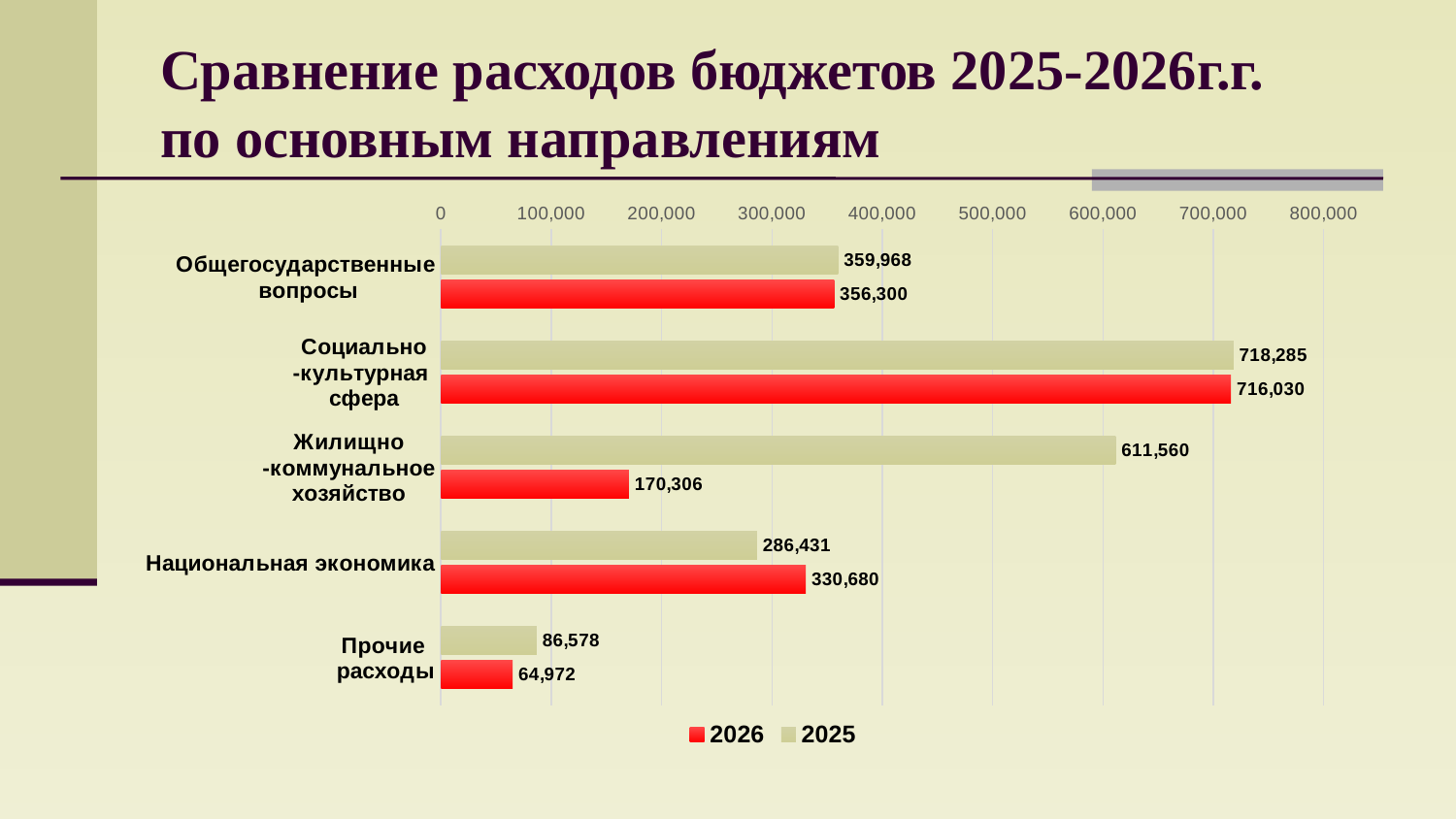
How many series does the legend list? 2 Which category has the highest 2026 value? Социально-культурная сфера Which category has the lowest 2025 value? Прочие расходы What is the 2026 value for Национальная экономика? 330,680 How many categories are shown on the chart? 5 What is the 2025 value for Жилищно-коммунальное хозяйство? 611,560 For Национальная экономика, which is larger: the 2025 value or the 2026 value? 2026 What kind of chart is shown on the slide? Bar chart Which colour represents the 2026 series? Red What is the 2026 value for Прочие расходы? 64,972 What is the 2025 value for Социально-культурная сфера? 718,285 What is the difference between the 2025 and 2026 values for Жилищно-коммунальное хозяйство? 441,254